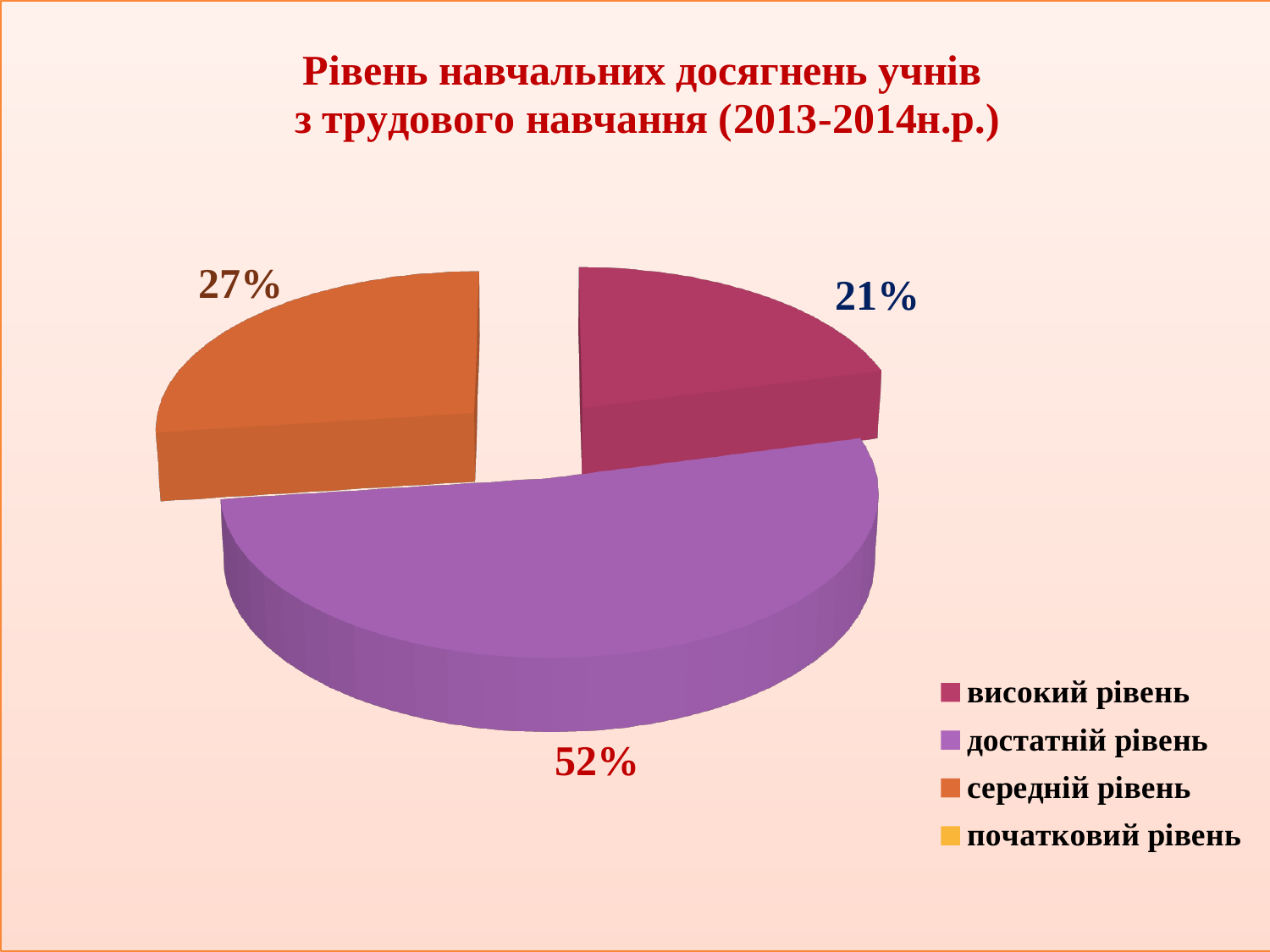
What share of the pie is labelled for середній рівень? 27% What is the difference between the shares for середній рівень and високий рівень? 6% Which level has the largest slice of the pie? достатній рівень Which of the labelled slices is the smallest? високий рівень What is the difference between the shares for достатній рівень and середній рівень? 25% How many entries does the legend list? 4 What colour is the slice for достатній рівень? purple How many slices with percentage labels are visible in the pie? 3 What share of the pie is labelled for високий рівень? 21% What kind of chart is shown on the slide? pie chart Which is larger, the slice for середній рівень or the slice for високий рівень? середній рівень What share of the pie is labelled for достатній рівень? 52%